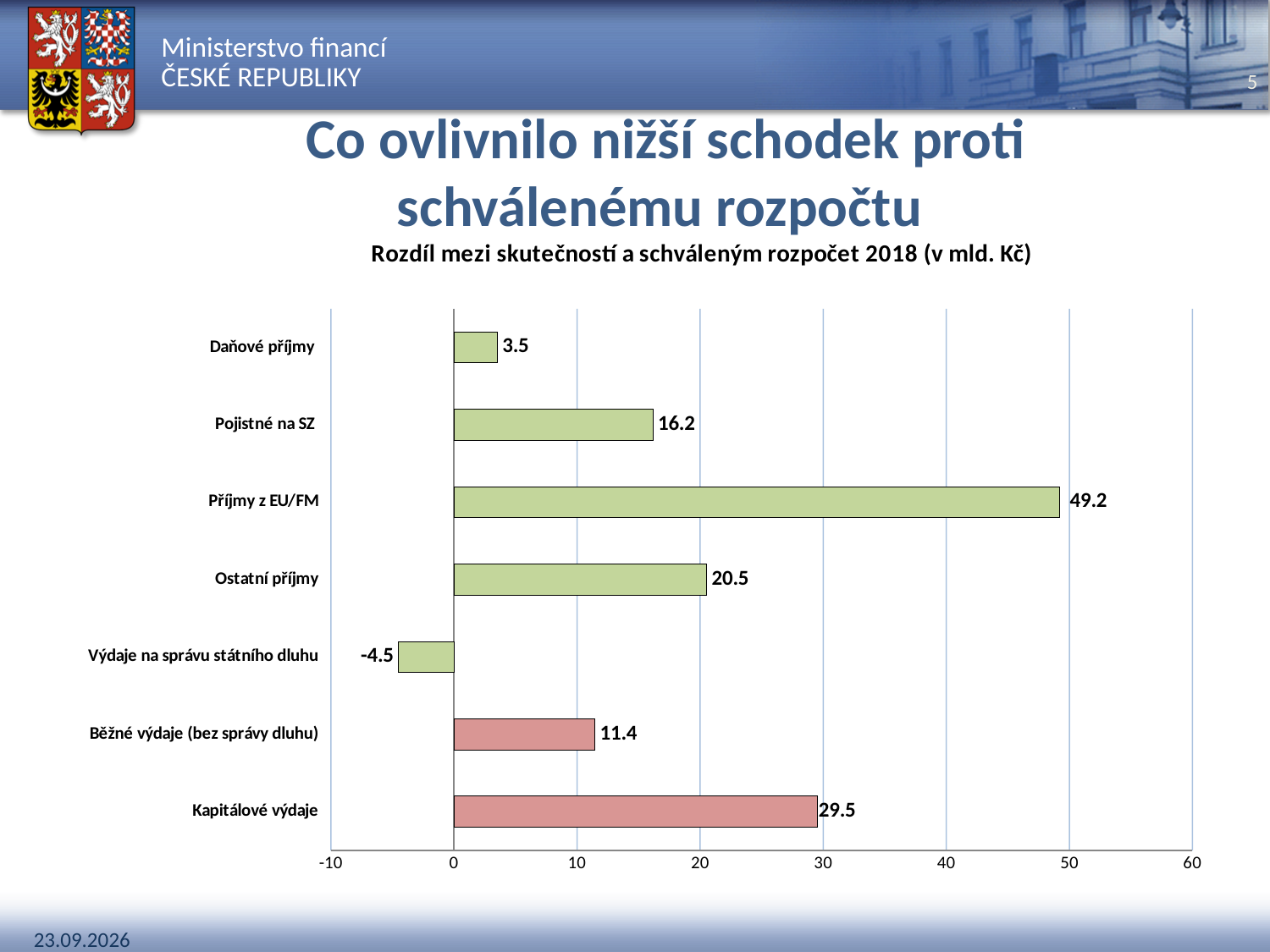
How many bars are coloured red/pink? 2 How many categories are shown in the chart? 7 What is the difference between the values for Ostatní příjmy and Pojistné na SZ? 4.3 What kind of chart is shown on the slide? bar chart What is the value for Výdaje na správu státního dluhu? -4.5 What is the value for Příjmy z EU/FM? 49.2 Which category has the lowest value? Výdaje na správu státního dluhu What is the subtitle of the chart? Rozdíl mezi skutečností a schváleným rozpočet 2018 (v mld. Kč) Which is larger, the value for Běžné výdaje (bez správy dluhu) or the value for Pojistné na SZ? Pojistné na SZ Which category has the highest value? Příjmy z EU/FM What is the value for Kapitálové výdaje? 29.5 Is the value for Kapitálové výdaje greater or less than 20? greater